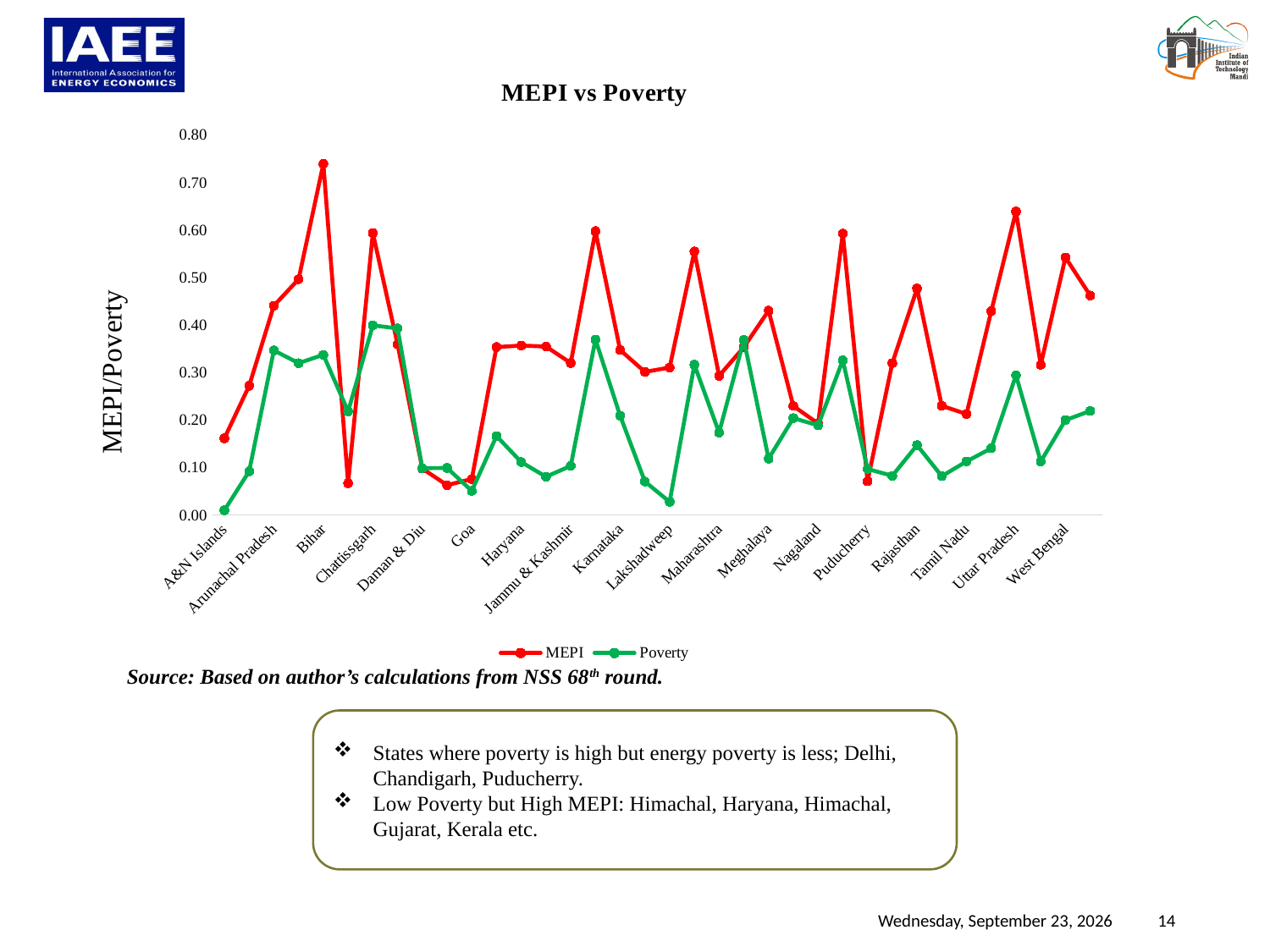
Is the MEPI value for Uttar Pradesh greater or less than 0.60? greater Is the Poverty value for Lakshadweep greater or less than 0.10? less Which colour is used for the Poverty series? Green Which has the larger Poverty value: Arunachal Pradesh or Goa? Arunachal Pradesh How many series does the legend list? 2 What kind of chart is shown on the slide? Line chart For Bihar, which is larger: the MEPI value or the Poverty value? MEPI What is the title of the chart? MEPI vs Poverty Is the MEPI value for Bihar greater or less than 0.70? greater Which state has the highest MEPI value? Bihar